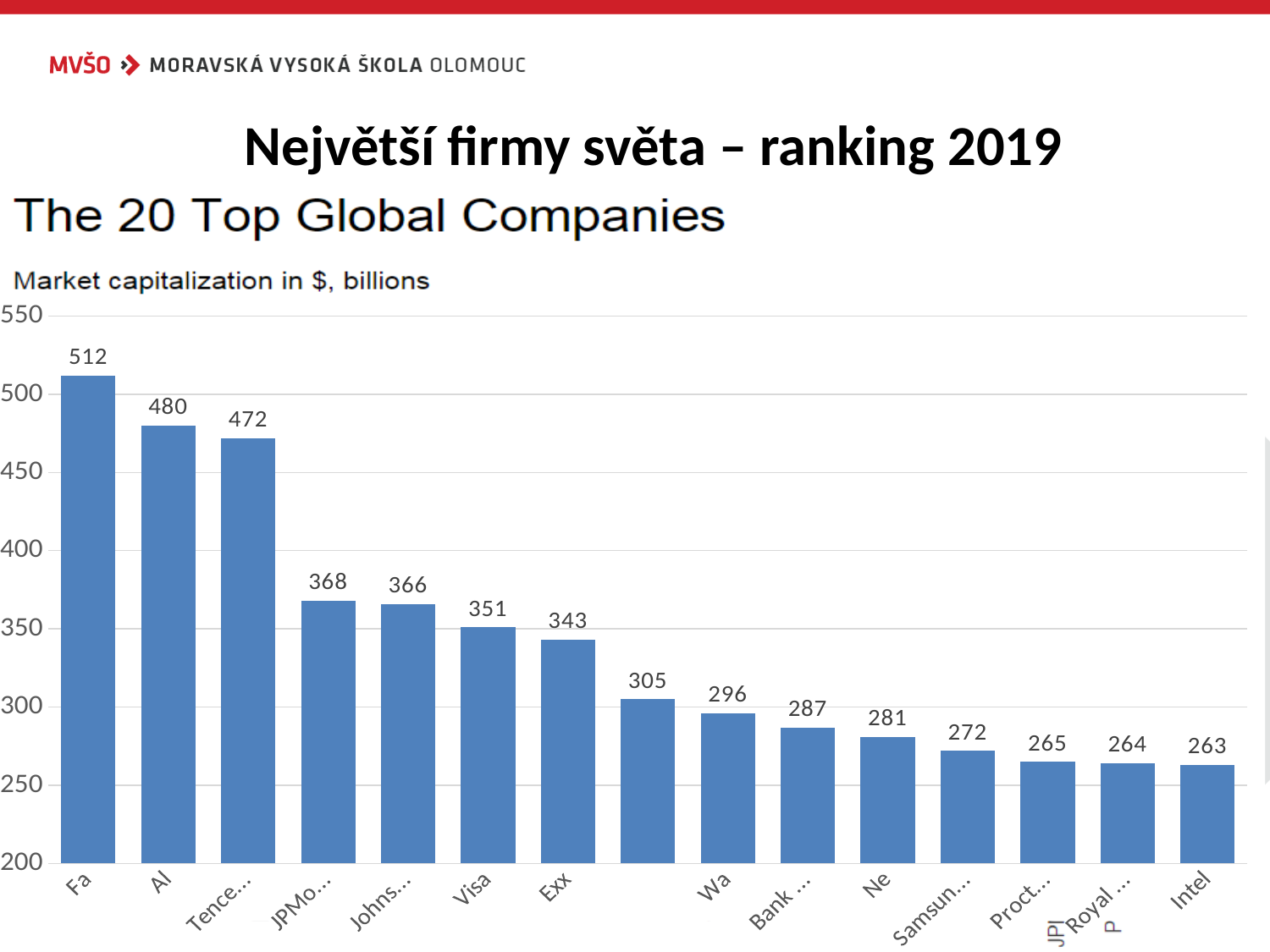
Which bar has the highest value in the chart? Fa (512) Which is larger, the value for Visa or the value for Intel? Visa What kind of chart is shown on the slide? bar chart Which bar has the lowest value in the chart? Intel (263) What is the value of the first (leftmost) bar, labelled "Fa"? 512 What unit is the market capitalization measured in, according to the chart subtitle? $, billions How many bars are plotted in the chart? 15 Is the value for Visa greater or less than 400? less What is the market capitalization value shown for Intel? 263 Do the values rise or fall from left to right along the x axis? fall What is the difference between the value for Visa and the value for Intel? 88 What is the market capitalization value shown for Visa? 351